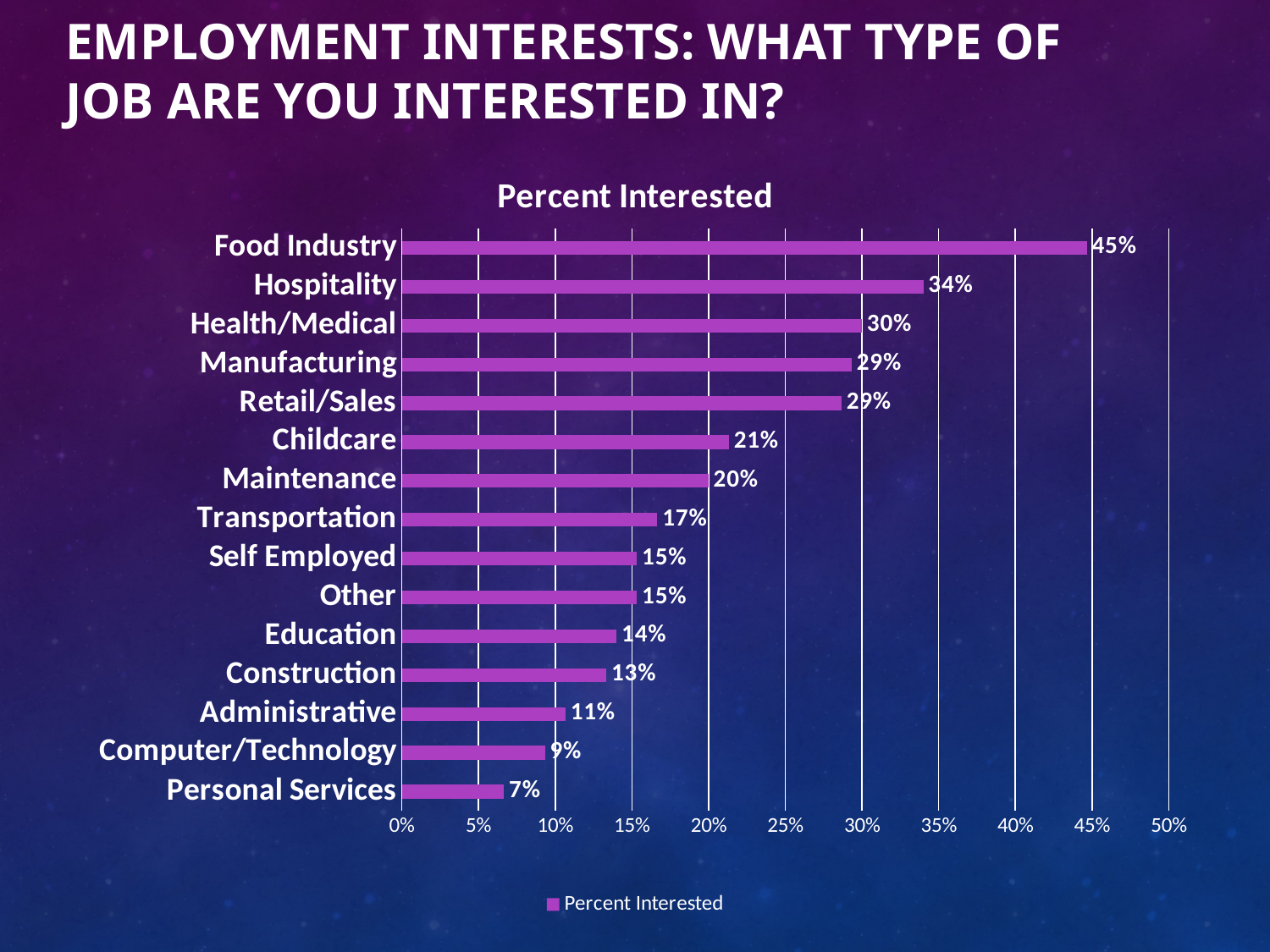
Is the value for Transportation greater or less than 20%? less What is the title of the chart? Percent Interested Which job type has the highest percent interested? Food Industry Which job type has the lowest percent interested? Personal Services How many job categories are shown in the chart? 15 What is the percent interested for Childcare? 21% What is the difference in percent interested between Food Industry and Hospitality? 11% What type of chart is shown on the slide? Bar chart What is the percent interested for Computer/Technology? 9% Which has a higher percent interested, Health/Medical or Maintenance? Health/Medical What is the percent interested for Food Industry? 45% How many series does the legend list? 1